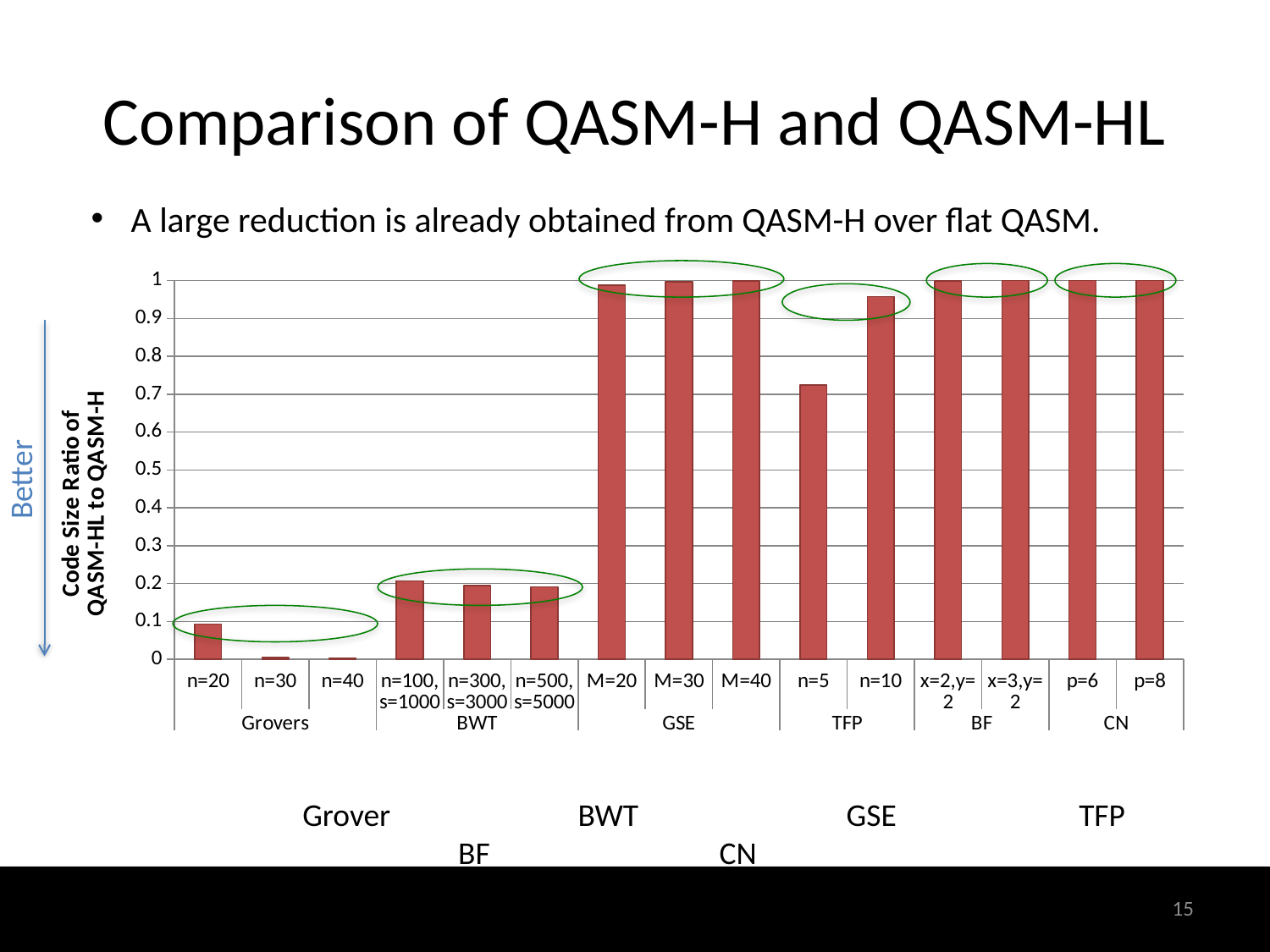
Is the value for n=10 in the TFP group greater or less than 0.9? greater Which is larger, the value for n=5 or the value for n=10 in the TFP group? n=10 How many bars are plotted in the chart? 15 Is the value for n=5 in the TFP group greater or less than 0.5? greater What is the title of the vertical axis of the chart? Code Size Ratio of QASM-HL to QASM-H Is the value for n=100, s=1000 in the BWT group greater or less than 0.3? less What kind of chart is shown on the slide? bar chart How many benchmark groups are labelled along the x axis of the chart? 6 Within the Grovers group, do the values rise or fall from n=20 to n=40? fall Which is larger, the value for n=20 in the Grovers group or the value for n=100, s=1000 in the BWT group? n=100, s=1000